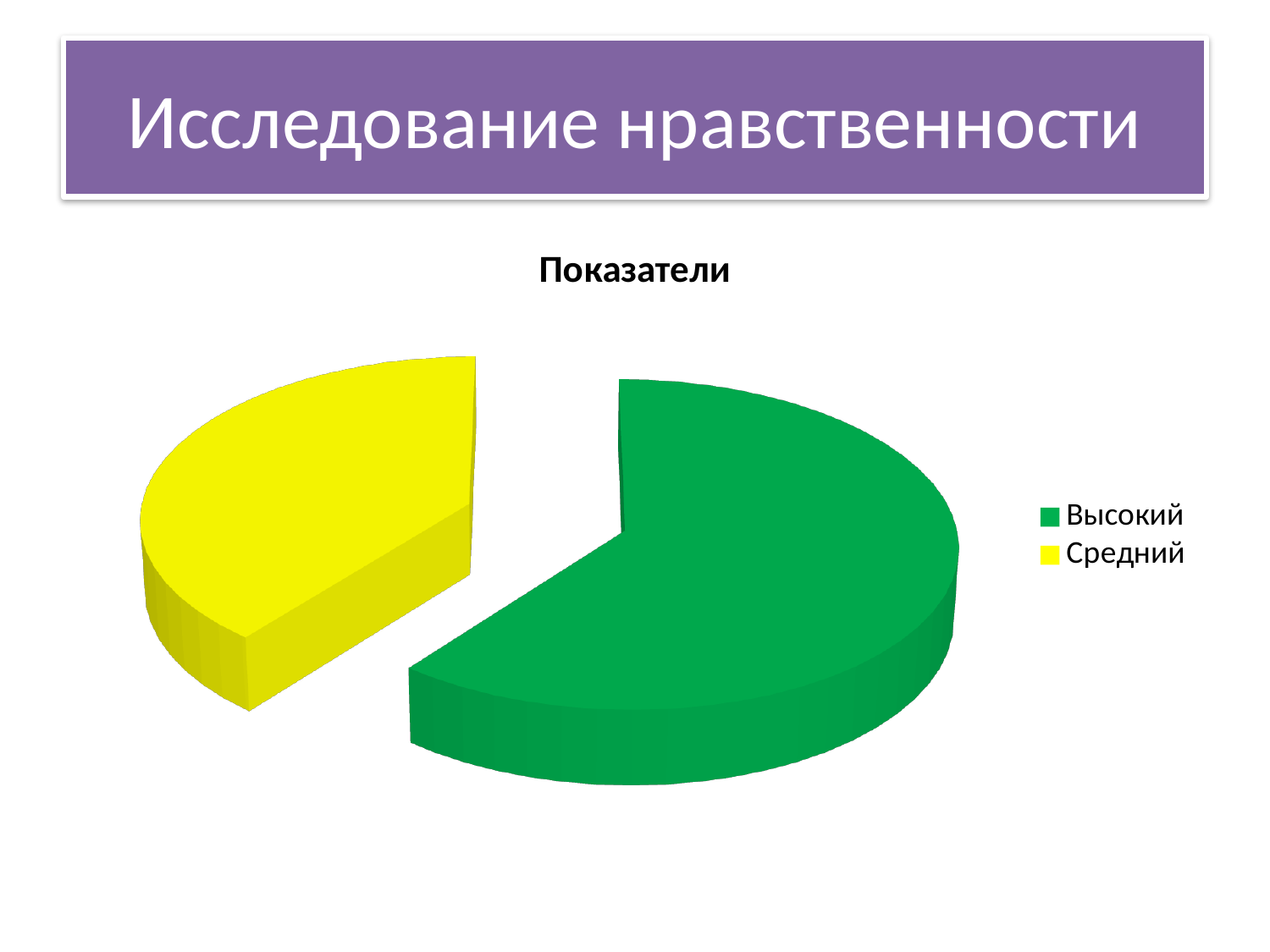
What colour is the slice for Средний? yellow Which slice is larger, Высокий or Средний? Высокий What kind of chart is shown on the slide? pie chart Which category has the smallest slice of the pie? Средний How many entries does the legend list? 2 What is the title of the chart? Показатели How many slices does the pie chart have? 2 Which category has the largest slice of the pie? Высокий